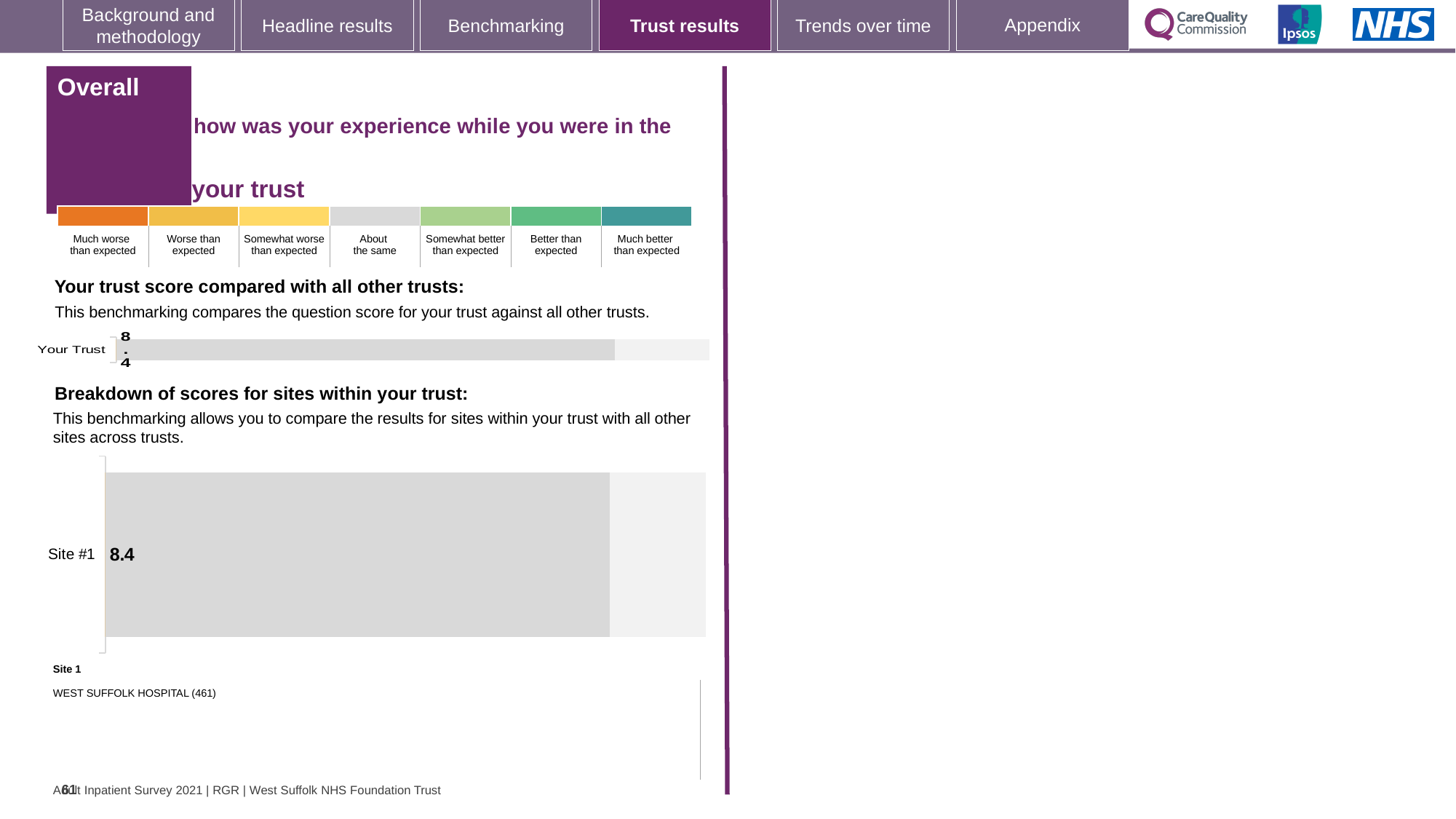
Is the Site #1 score in the site breakdown chart higher, lower, or the same as the Your Trust score in the trust comparison chart? the same What kind of chart is used in the 'Breakdown of scores for sites within your trust' section? bar chart According to the site key below the breakdown chart, which hospital is Site 1? WEST SUFFOLK HOSPITAL (461) How many bars are shown in the 'Your trust score compared with all other trusts' chart? 1 How many sites are plotted in the 'Breakdown of scores for sites within your trust' chart? 1 What is the label of the only category in the 'Breakdown of scores for sites within your trust' chart? Site #1 What is the difference between the Your Trust score and the Site #1 score? 0.0 In the 'Your trust score compared with all other trusts' chart, what is the score for Your Trust? 8.4 In the 'Breakdown of scores for sites within your trust' chart, what is the score for Site #1? 8.4